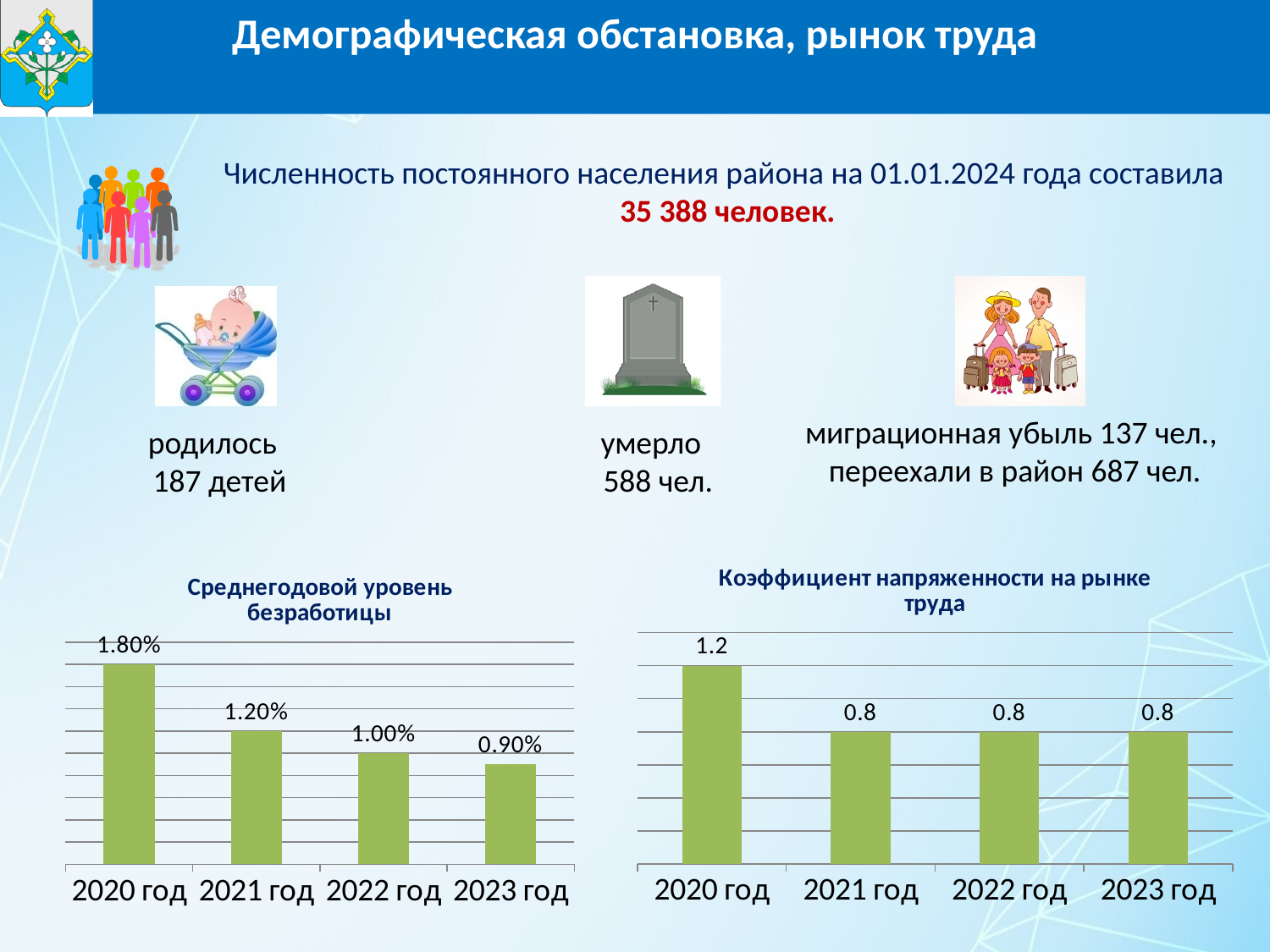
In the chart 'Среднегодовой уровень безработицы', what is the value for 2020 год? 1.80% In the chart 'Среднегодовой уровень безработицы', what is the difference between the values for 2020 год and 2021 год? 0.60% In the chart 'Среднегодовой уровень безработицы', which year has the highest value? 2020 год How many categories are shown in the chart 'Коэффициент напряженности на рынке труда'? 4 In the chart 'Среднегодовой уровень безработицы', which year has the lowest value? 2023 год In the chart 'Коэффициент напряженности на рынке труда', what is the value for 2022 год? 0.8 In the chart 'Коэффициент напряженности на рынке труда', what is the difference between the values for 2020 год and 2021 год? 0.4 What kind of chart is 'Среднегодовой уровень безработицы'? bar chart In the chart 'Коэффициент напряженности на рынке труда', what is the value for 2020 год? 1.2 In the chart 'Коэффициент напряженности на рынке труда', which year has the highest value? 2020 год In the chart 'Среднегодовой уровень безработицы', what is the value for 2023 год? 0.90% In the chart 'Среднегодовой уровень безработицы', do the values rise or fall from 2020 год to 2023 год? fall